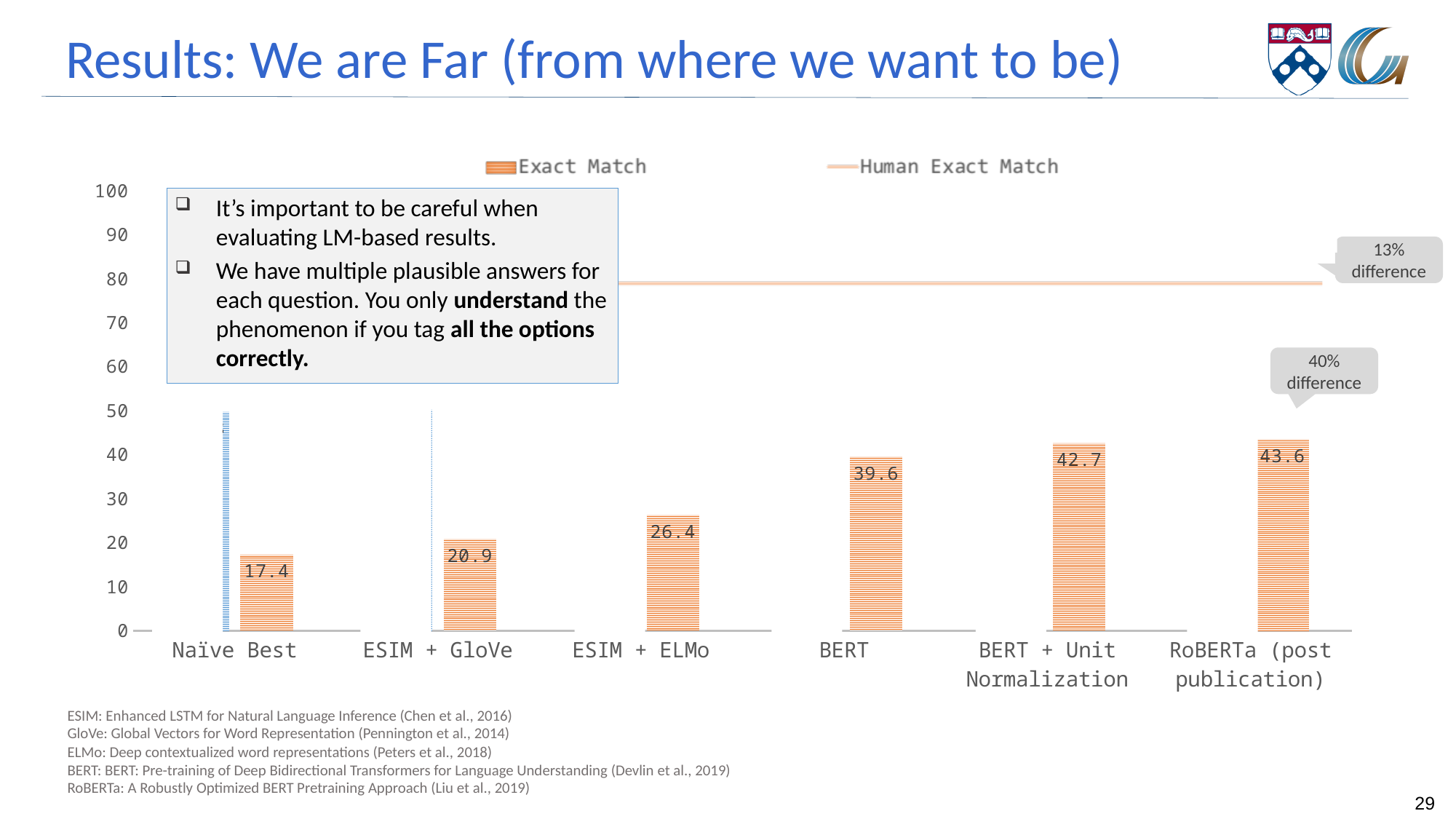
Which model has the lowest Exact Match score? Naïve Best Do the Exact Match scores rise or fall from left to right along the x axis? Rise What is the Exact Match value for ESIM + ELMo? 26.4 What is the Exact Match value for BERT? 39.6 How many series does the chart legend list? 2 What is the Exact Match value for Naïve Best? 17.4 What kind of chart is used to show the Exact Match scores? Bar chart Which has a higher Exact Match score, ESIM + GloVe or ESIM + ELMo? ESIM + ELMo Is the Human Exact Match line greater or less than 70? greater What is the difference in Exact Match between BERT + Unit Normalization and BERT? 3.1 How many models are shown on the x axis of the chart? 6 Which model has the highest Exact Match score? RoBERTa (post publication)